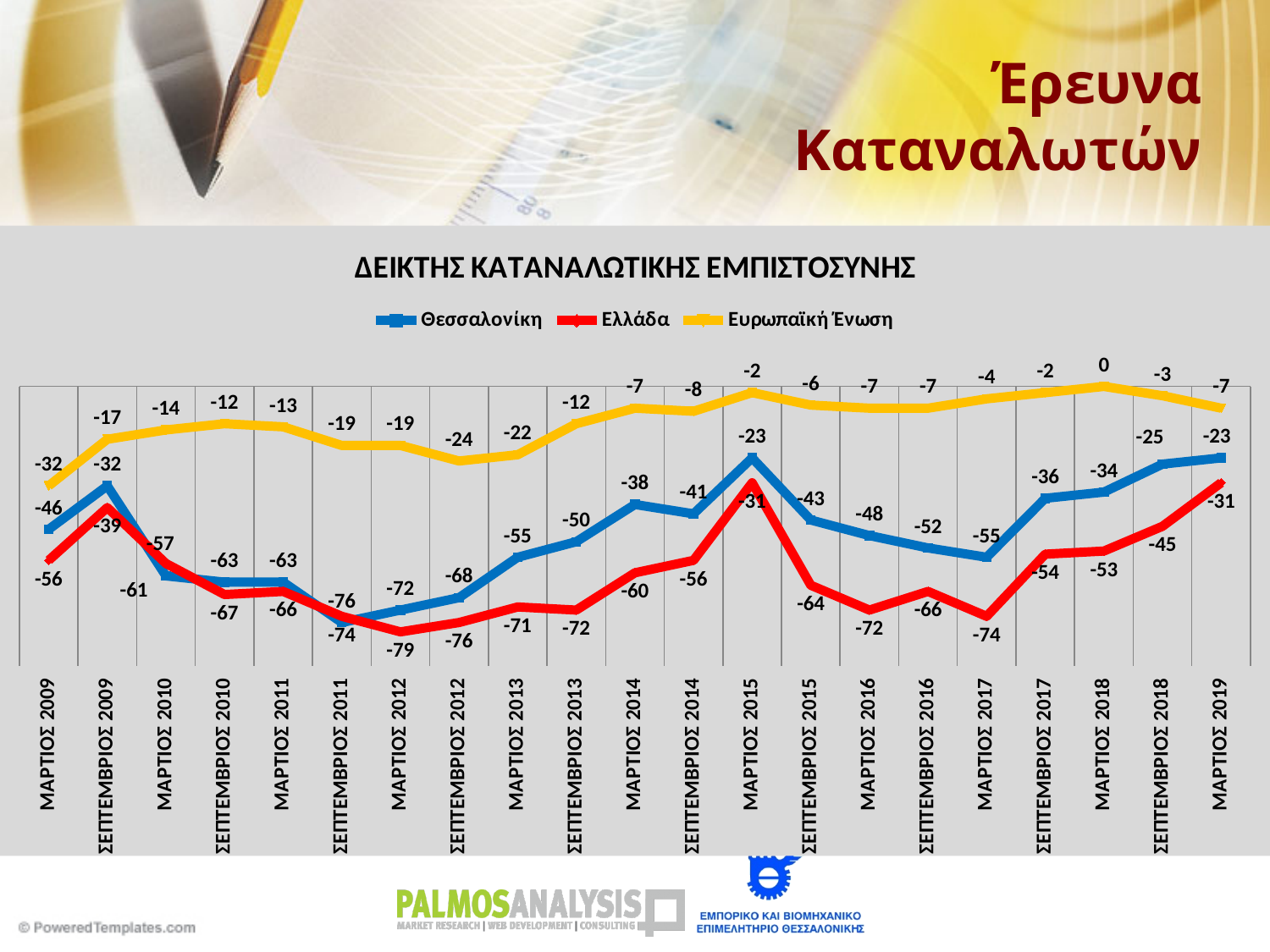
What type of chart is shown on the slide? Line chart What is the difference between the Θεσσαλονίκη and Ελλάδα values in ΜΑΡΤΙΟΣ 2019? 8 What is the value for Ευρωπαϊκή Ένωση in ΜΑΡΤΙΟΣ 2018? 0 In ΜΑΡΤΙΟΣ 2012, which series has the higher value, Θεσσαλονίκη or Ελλάδα? Θεσσαλονίκη What is the title of the chart? ΔΕΙΚΤΗΣ ΚΑΤΑΝΑΛΩΤΙΚΗΣ ΕΜΠΙΣΤΟΣΥΝΗΣ What is the value for Ελλάδα in ΜΑΡΤΙΟΣ 2012? -79 What is the value for Θεσσαλονίκη in ΜΑΡΤΙΟΣ 2015? -23 In which period does the Ελλάδα series reach its lowest value? ΜΑΡΤΙΟΣ 2012 In which period does the Θεσσαλονίκη series reach its lowest value? ΣΕΠΤΕΜΒΡΙΟΣ 2011 How many time points are plotted along the x axis of the chart? 21 In which period does the Ευρωπαϊκή Ένωση series reach its highest value? ΜΑΡΤΙΟΣ 2018 How many series does the legend of the chart list? 3